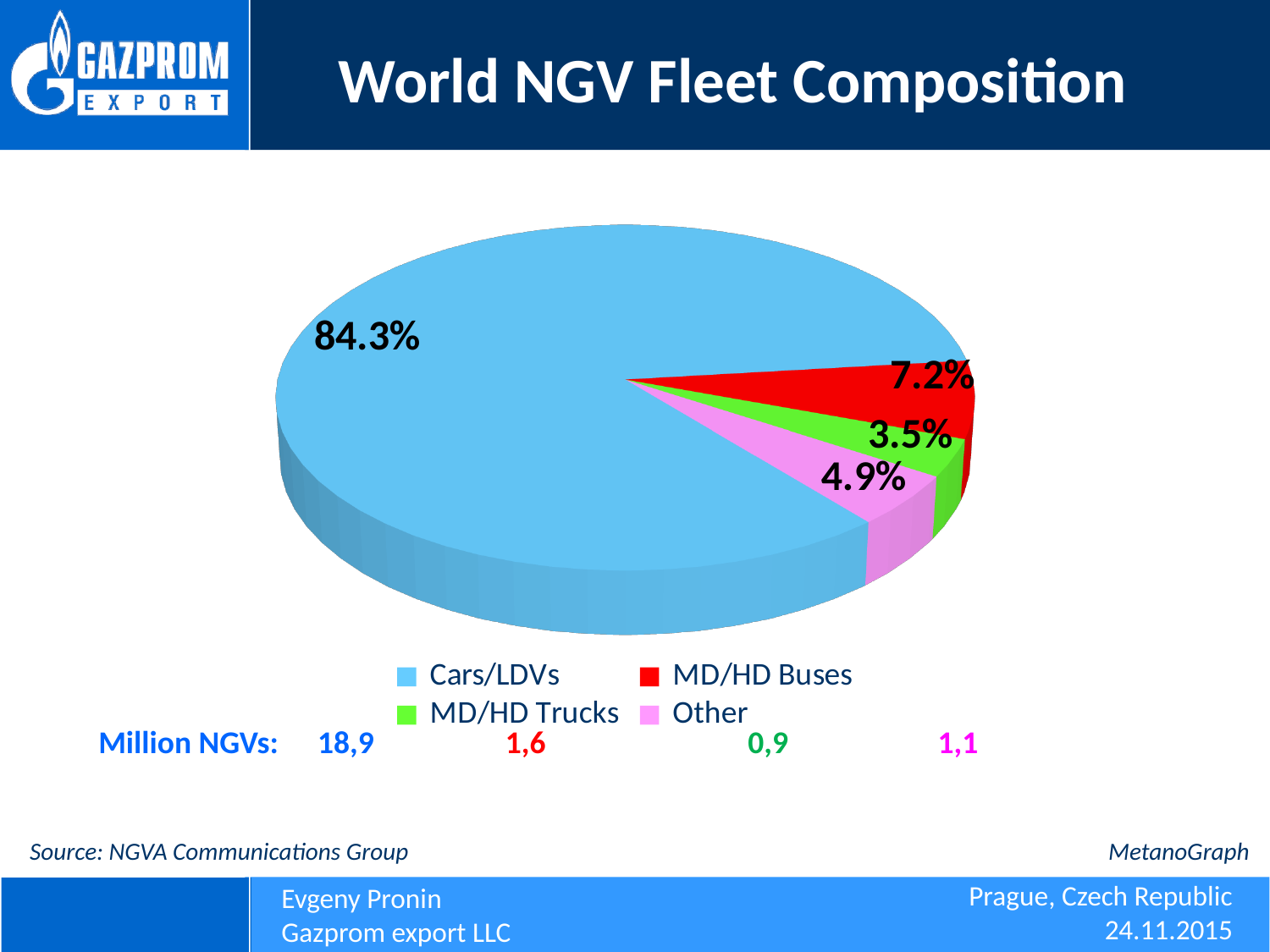
Which slice is larger, MD/HD Buses or Other? MD/HD Buses How many categories does the legend list? 4 What share of the pie does MD/HD Buses hold? 7.2% Which category has the smallest slice of the pie? MD/HD Trucks What share of the pie does Other hold? 4.9% Which category has the largest slice of the pie? Cars/LDVs What is the difference in percentage points between the MD/HD Buses slice and the MD/HD Trucks slice? 3.7 What share of the pie does Cars/LDVs hold? 84.3% What is the title of the chart? World NGV Fleet Composition What kind of chart is shown on the slide? pie chart What colour is the Cars/LDVs slice in the pie chart? light blue